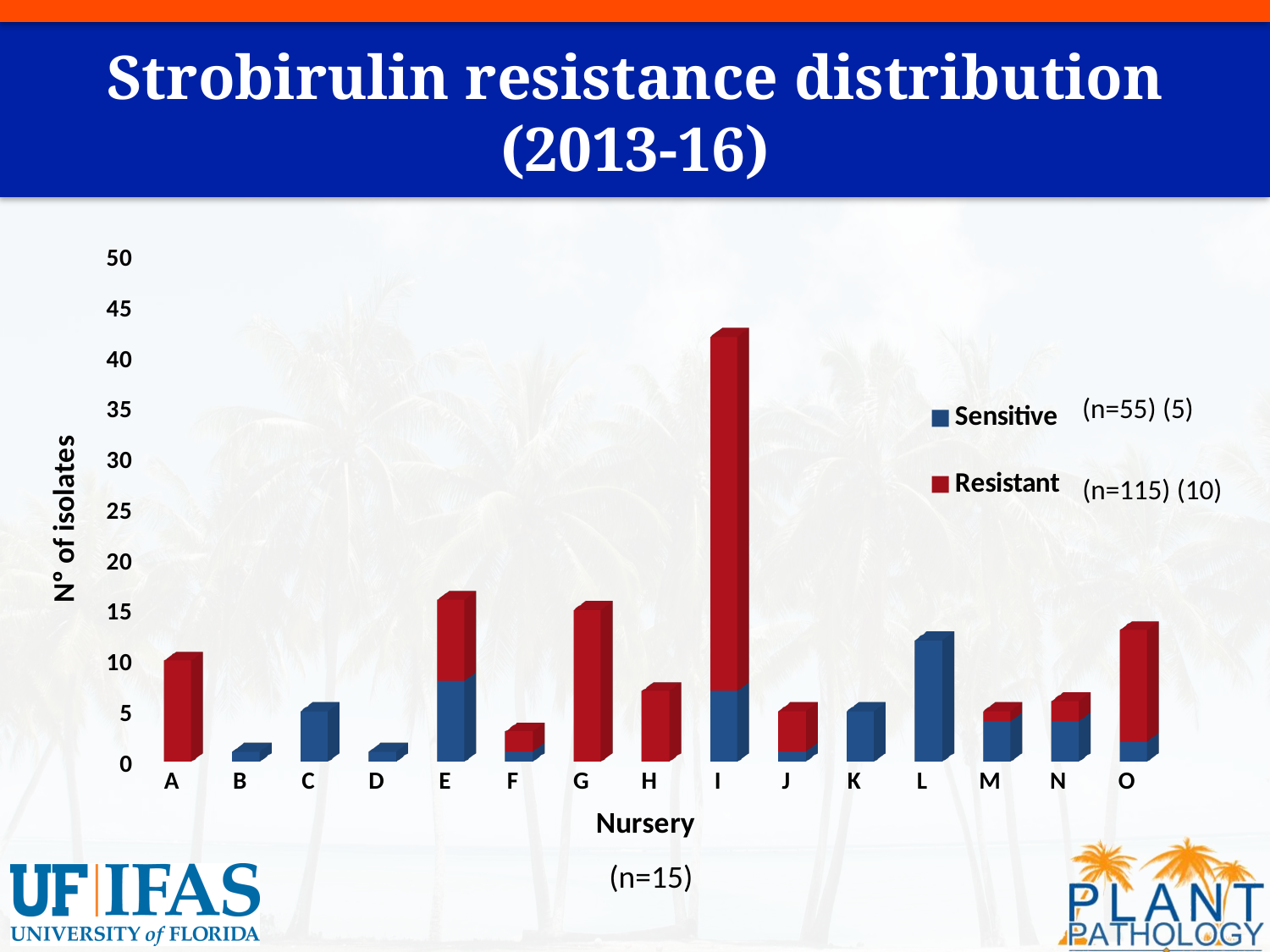
Which has a larger number of isolates, nursery L or nursery C? L Which has a larger total number of isolates, nursery I or nursery G? I What are the two series named in the legend? Sensitive and Resistant Which nursery has the highest total number of isolates? I Is the value for nursery L greater or less than 10? greater What is the label on the y axis? N° of isolates How many series does the legend list? 2 Is the total value for nursery A greater or less than 5? greater How many nurseries (categories) are shown on the x axis? 15 Is the total value for nursery G less or greater than 20? less What kind of chart is shown on the slide? Stacked bar chart